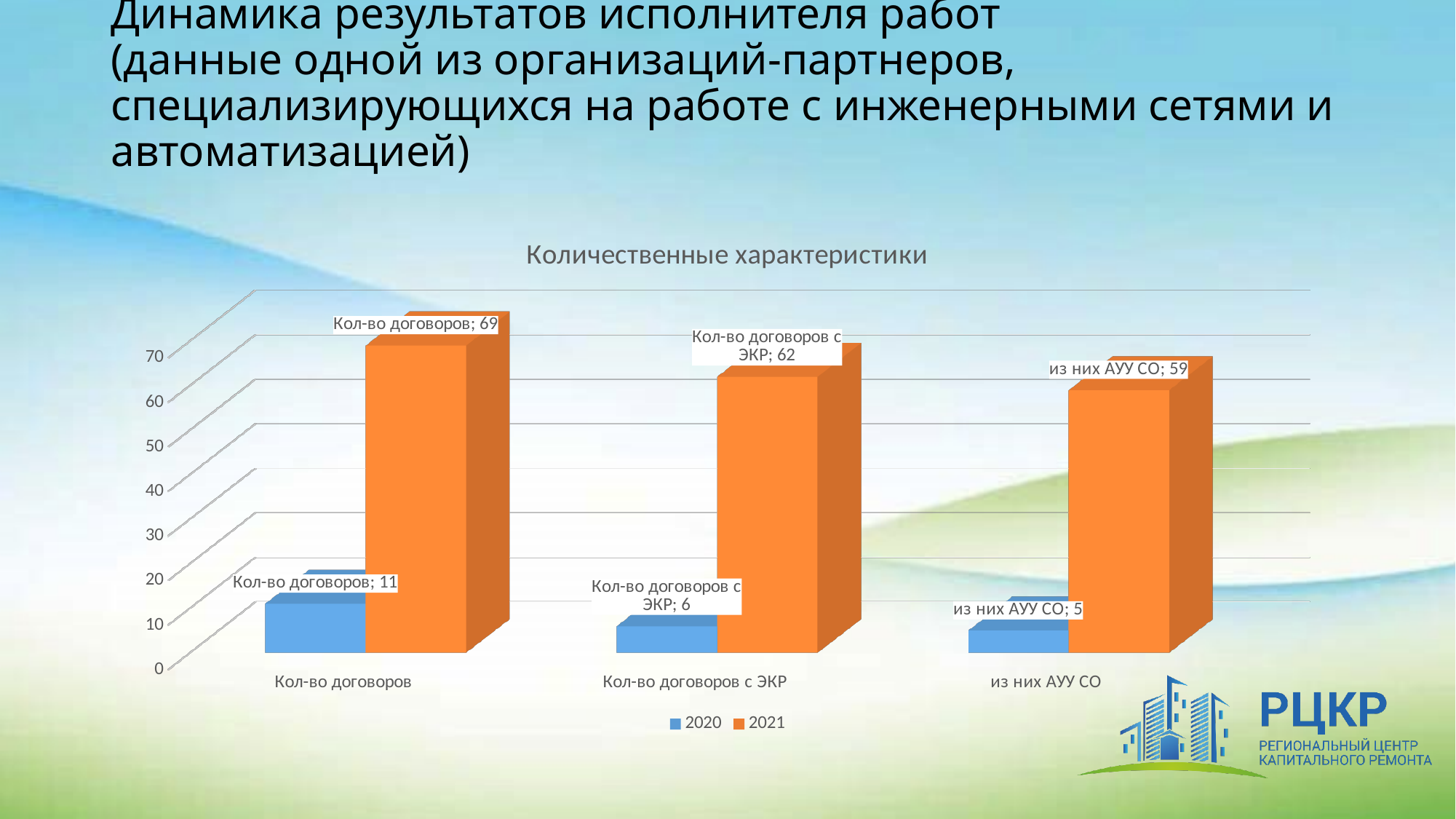
Which category has the highest value for the 2021 series? Кол-во договоров What is the value for 2020 in the 'Кол-во договоров с ЭКР' category? 6 What is the value for 2020 in the 'из них АУУ СО' category? 5 Which is larger: the 2021 value for 'Кол-во договоров с ЭКР' or the 2021 value for 'из них АУУ СО'? Кол-во договоров с ЭКР What kind of chart is shown on the slide? Bar chart What is the title of the chart? Количественные характеристики What is the difference between the 2021 and 2020 values for 'Кол-во договоров'? 58 What is the value for 2021 in the 'из них АУУ СО' category? 59 What is the value for 2021 in the 'Кол-во договоров' category? 69 Which category has the lowest value for the 2020 series? из них АУУ СО How many categories are shown on the x axis? 3 How many series does the legend list? 2